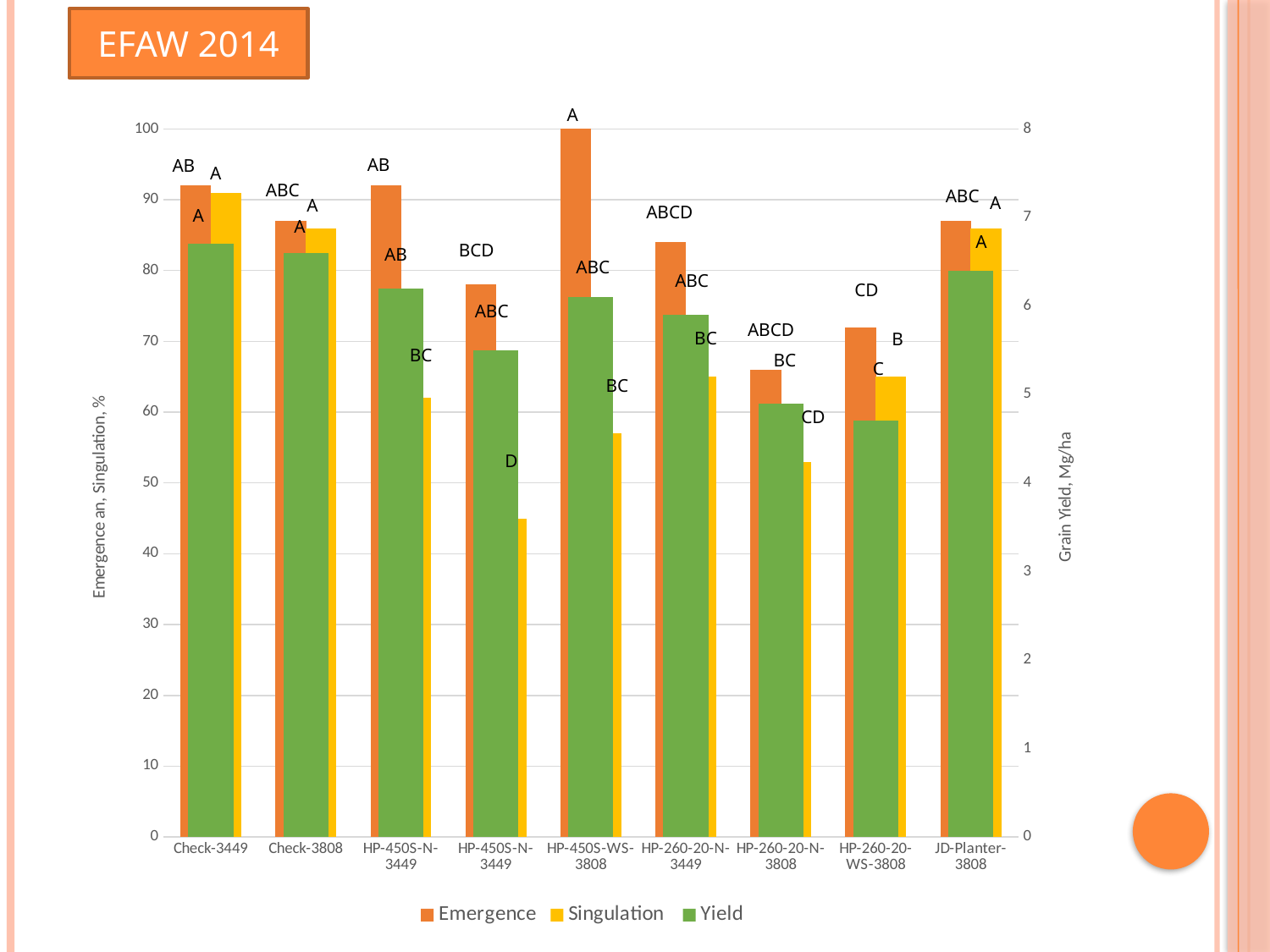
What is the label of the right-hand vertical axis? Grain Yield, Mg/ha Which is larger for Check-3449: the Emergence value or the Singulation value? Emergence How many categories are shown along the x axis? 9 Which category has the highest Emergence value? HP-450S-WS-3808 Which category has the highest Singulation value? Check-3449 Which category has the lowest Emergence value? HP-260-20-N-3808 Is the Emergence value for HP-260-20-N-3808 greater or less than 70? less How many series does the legend list? 3 What kind of chart is shown on the slide? bar chart What is the Emergence value for HP-450S-WS-3808? 100 Is the Yield value for JD-Planter-3808 greater or less than 6 Mg/ha on the right axis? greater Is the Singulation value for HP-450S-WS-3808 greater or less than 50? greater